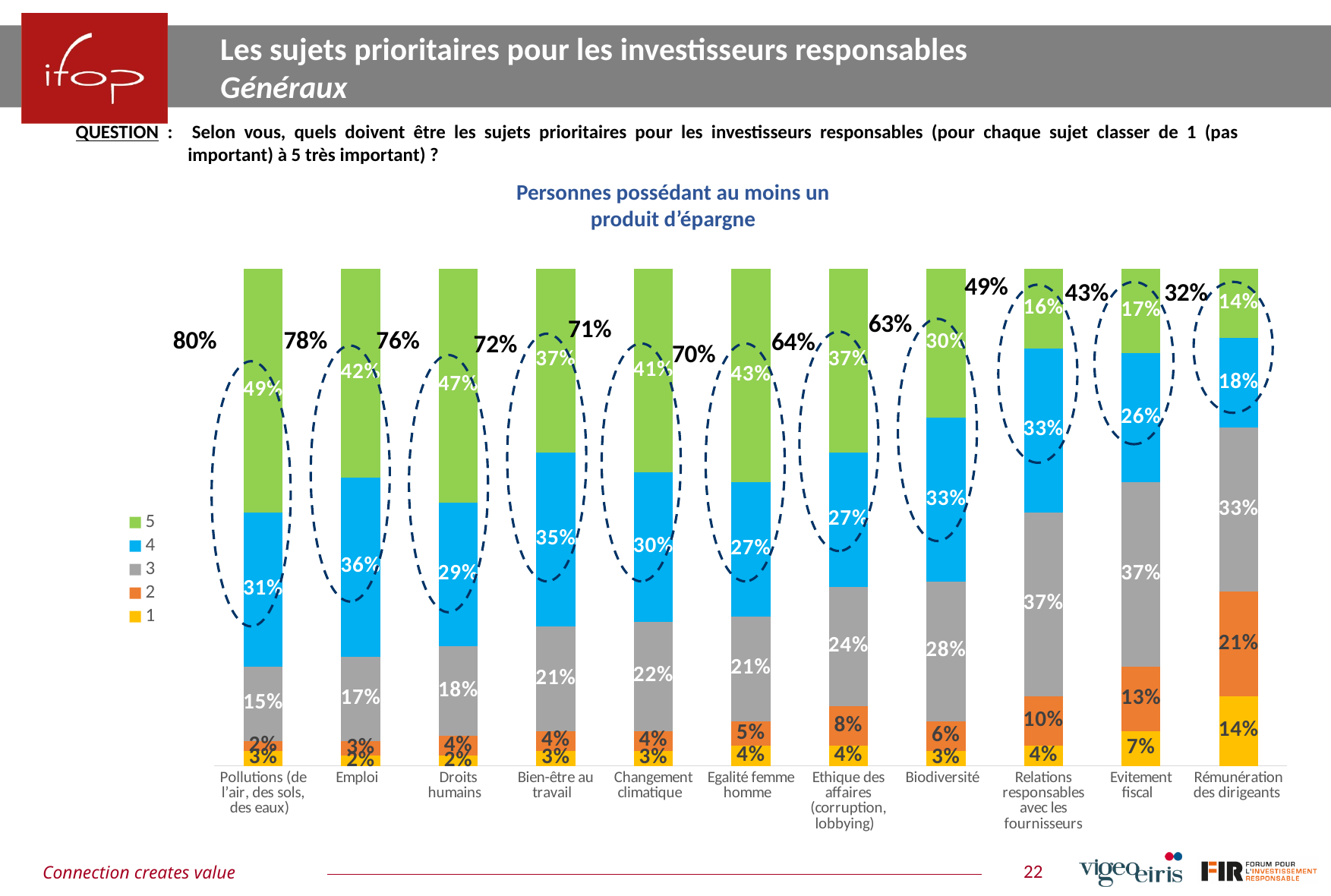
What is the value of series 5 for 'Pollutions (de l'air, des sols, des eaux)'? 49% Which category has the highest value for series 5? Pollutions (de l'air, des sols, des eaux) What is the combined total of series 4 and series 5 for 'Relations responsables avec les fournisseurs'? 49% Which category has the lowest value for series 5? Rémunération des dirigeants What type of chart is shown on the slide? Stacked bar chart How many categories (subjects) are shown on the x axis? 11 Which is larger: the series 3 value for 'Biodiversité' or for 'Ethique des affaires (corruption, lobbying)'? Biodiversité What is the value of series 2 for 'Rémunération des dirigeants'? 21% What is the difference between the series 4 values for 'Emploi' and 'Droits humains'? 7% What is the value of series 3 for 'Evitement fiscal'? 37% What is the title shown above the chart? Personnes possédant au moins un produit d'épargne How many series does the legend list? 5